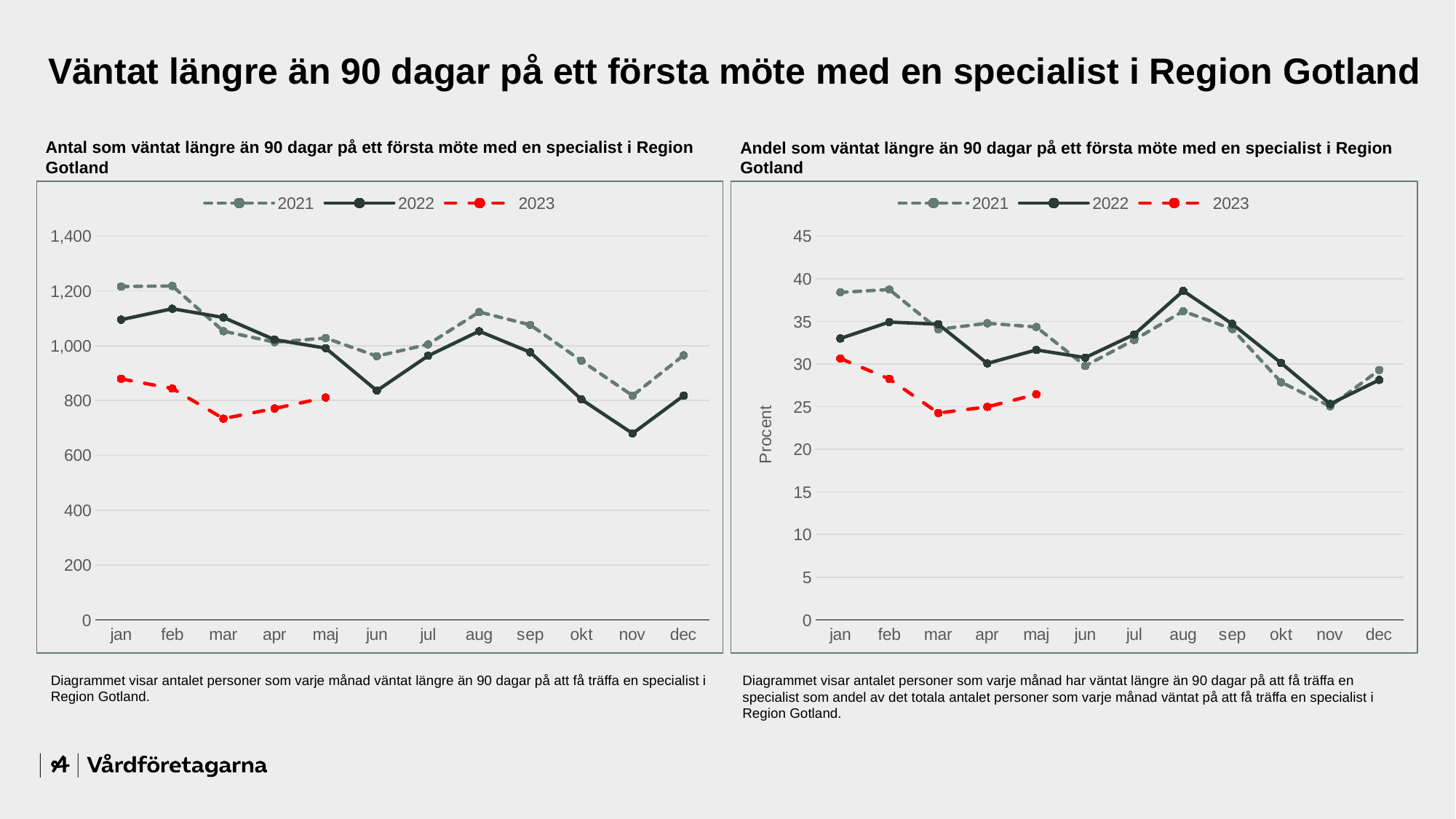
In the left chart, 'Antal som väntat längre än 90 dagar...', is the 2022 value for nov greater or less than 800? less In the right chart, 'Andel som väntat längre än 90 dagar...', which series has the higher value in aug, 2021 or 2022? 2022 How many months are shown on the x axis of the left chart, 'Antal som väntat längre än 90 dagar...'? 12 What kind of chart is the left chart, 'Antal som väntat längre än 90 dagar på ett första möte med en specialist i Region Gotland'? Line chart In the left chart, 'Antal som väntat längre än 90 dagar...', does the 2023 series rise or fall from jan to mar? Fall In the left chart, 'Antal som väntat längre än 90 dagar...', in which month is the 2022 value highest? feb In the left chart, 'Antal som väntat längre än 90 dagar...', which series has the higher value in jan, 2021 or 2022? 2021 In the left chart, 'Antal som väntat längre än 90 dagar...', in which month is the 2022 value lowest? nov In the left chart, 'Antal som väntat längre än 90 dagar...', is the 2021 value for aug greater or less than 1,000? greater In the right chart, 'Andel som väntat längre än 90 dagar...', is the 2022 value for nov greater or less than 30? less In the right chart, 'Andel som väntat längre än 90 dagar...', in which month is the 2022 value highest? aug How many series does the legend of the right chart, 'Andel som väntat längre än 90 dagar...', list? 3